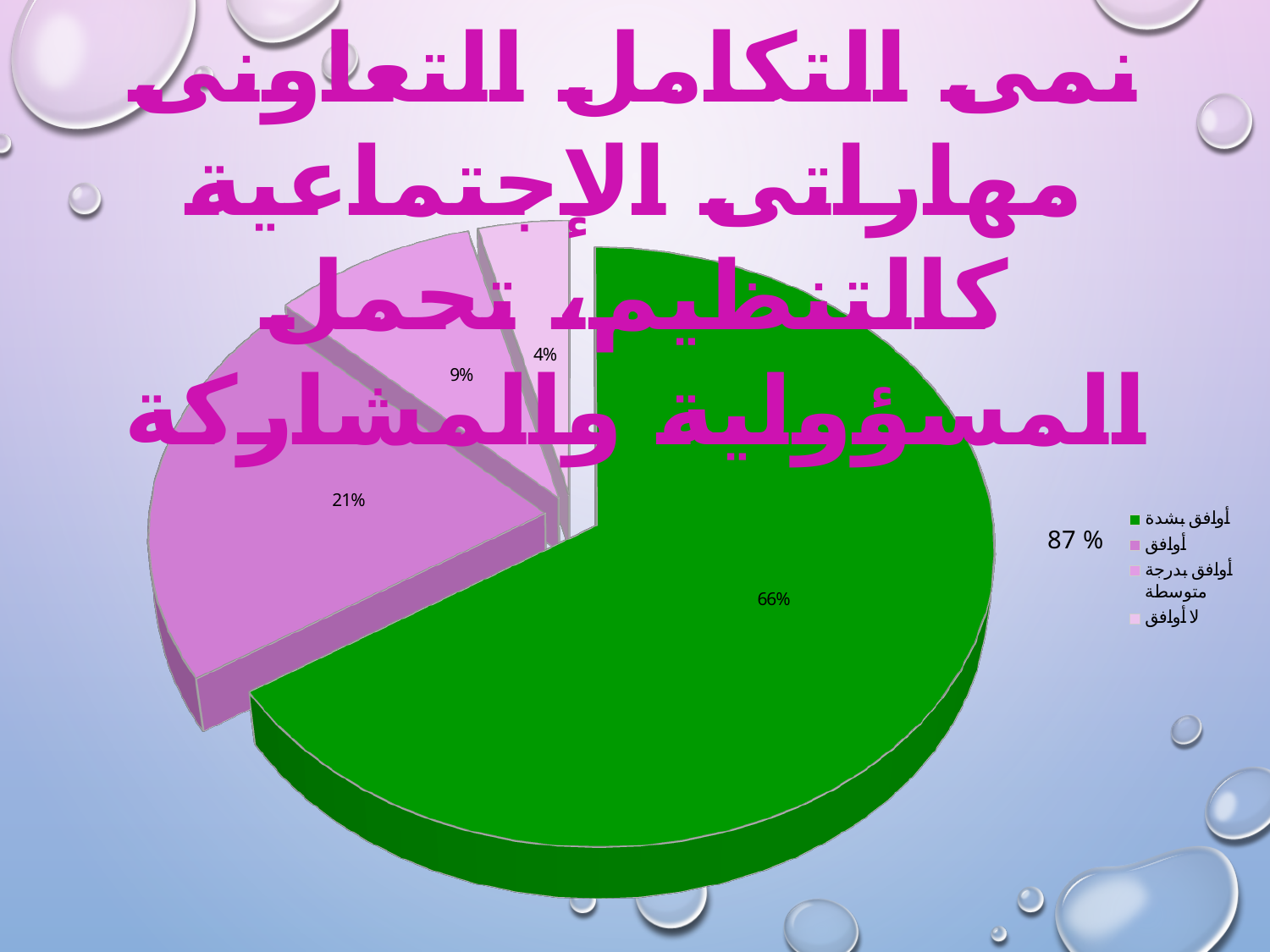
What percentage is shown for the 'أوافق' (agree) slice? 21% How many entries does the legend list? 4 Which category has the largest slice of the pie? أوافق بشدة What percentage is shown for the 'أوافق بدرجة متوسطة' (moderately agree) slice? 9% What colour is the 'أوافق بشدة' slice in the pie chart? green How many slices does the pie chart have? 4 Which category has the smallest slice of the pie? لا أوافق What percentage is shown for the 'لا أوافق' (disagree) slice? 4% What kind of chart is shown on the slide? pie chart What percentage of the pie is labelled for the 'أوافق بشدة' (strongly agree) slice? 66% Which slice is larger, 'أوافق' or 'أوافق بدرجة متوسطة'? أوافق What is the difference in percentage points between the 'أوافق بشدة' slice and the 'أوافق' slice? 45